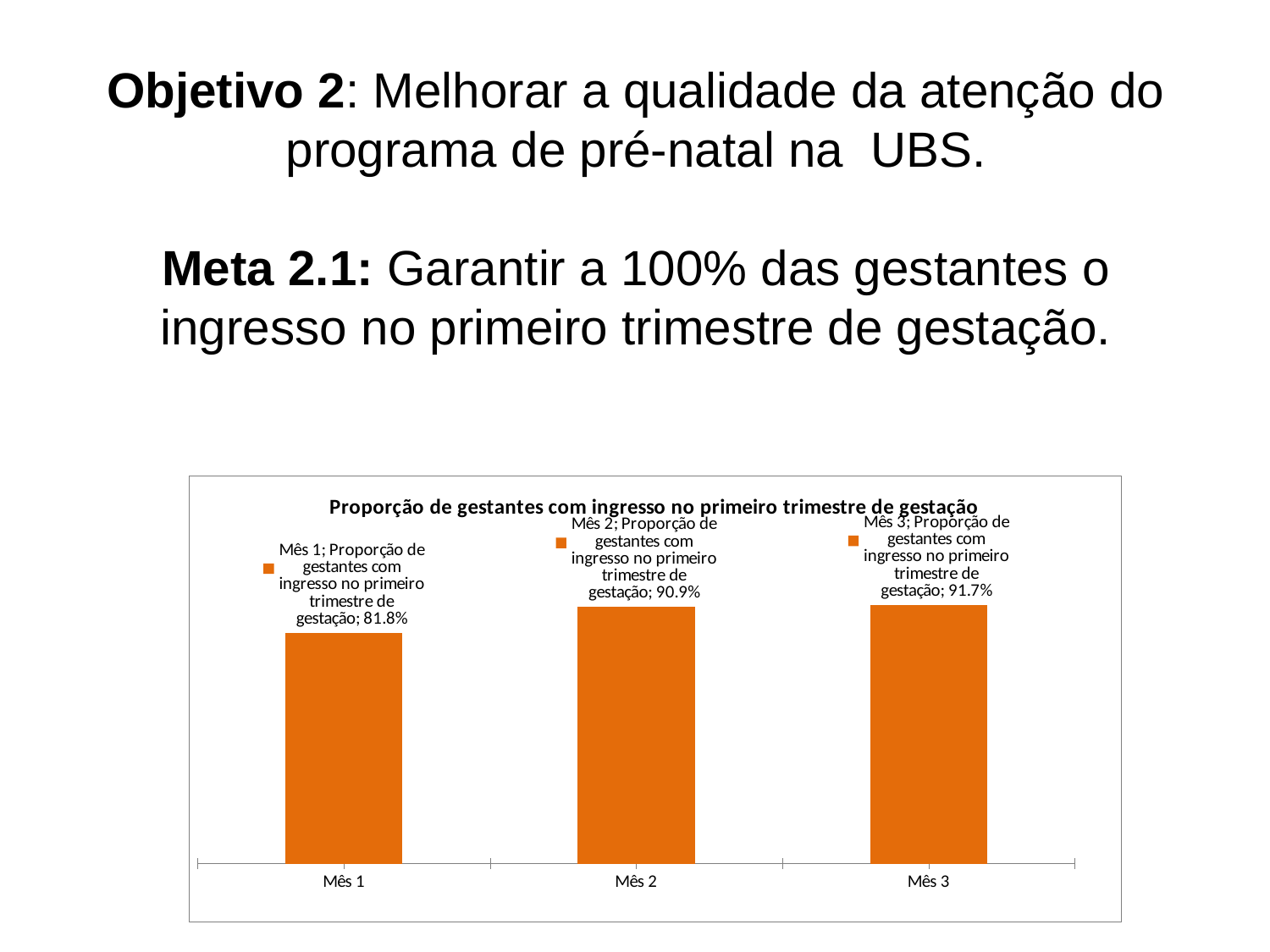
What is the difference between the values for Mês 3 and Mês 1? 9.9 percentage points What is the value for Mês 2 in the chart? 90.9% What is the value for Mês 1 in the chart? 81.8% What kind of chart is shown on the slide? Bar chart What is the difference between the values for Mês 2 and Mês 1? 9.1 percentage points What is the value for Mês 3 in the chart? 91.7% Which is larger, the value for Mês 1 or the value for Mês 2? Mês 2 How many months are shown on the x axis of the chart? 3 What is the title of the chart? Proporção de gestantes com ingresso no primeiro trimestre de gestação Do the values rise or fall from Mês 1 to Mês 3? Rise Which month has the highest proportion of pregnant women entering in the first trimester? Mês 3 Which month has the lowest proportion of pregnant women entering in the first trimester? Mês 1